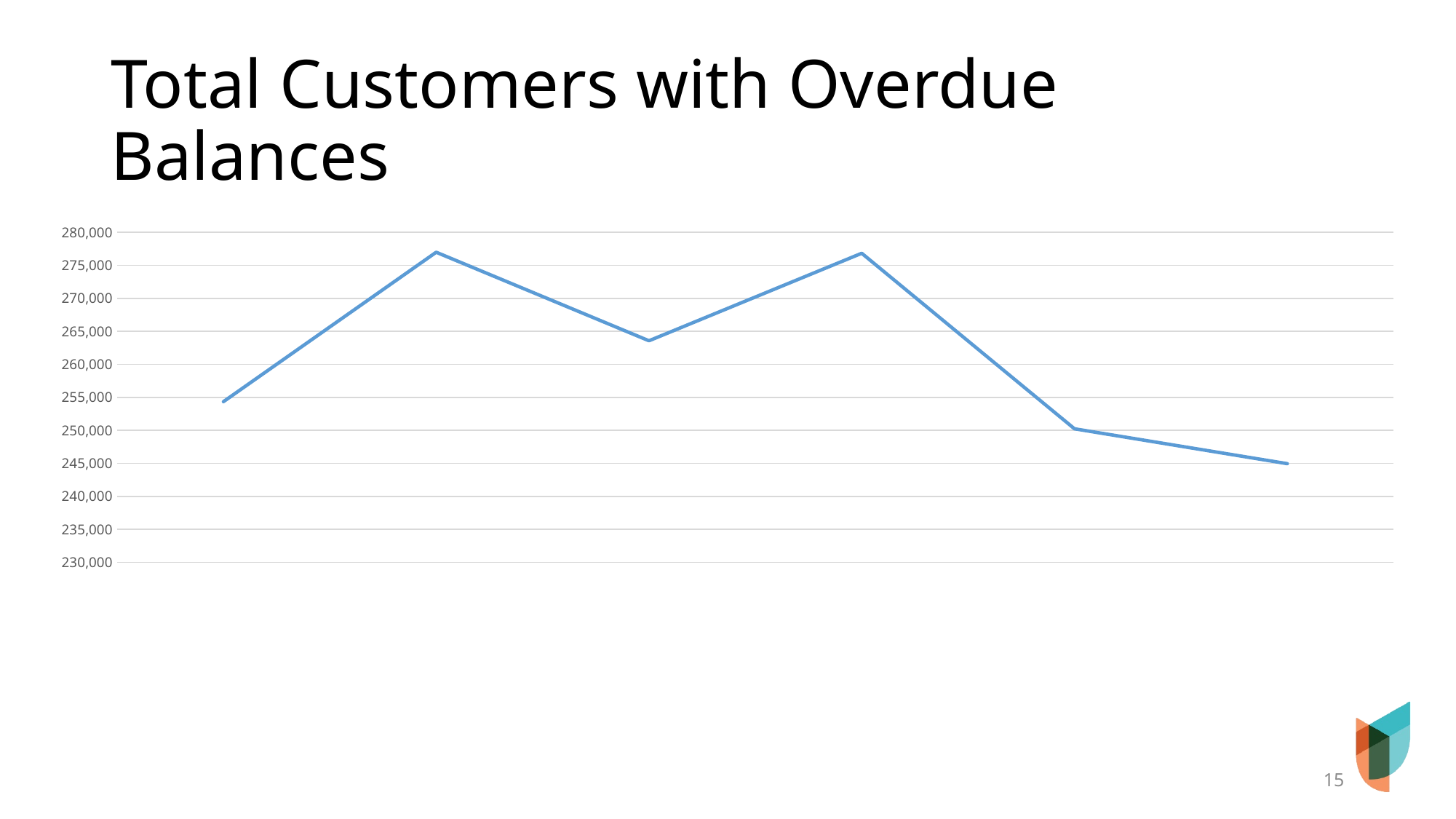
Which point on the line has the lowest value, the first or the last? the last Is the value of the third point on the line greater or less than 265,000? less What is the title of the chart on the slide? Total Customers with Overdue Balances Is the value of the first point on the line greater or less than 260,000? less How many data points are plotted on the line? 6 Is the value of the last point on the line greater or less than 250,000? less Which is larger, the value of the second point or the value of the third point? the second point What is the highest value shown on the vertical axis? 280,000 Does the line end higher or lower than it starts? lower What kind of chart is shown on the slide? line chart